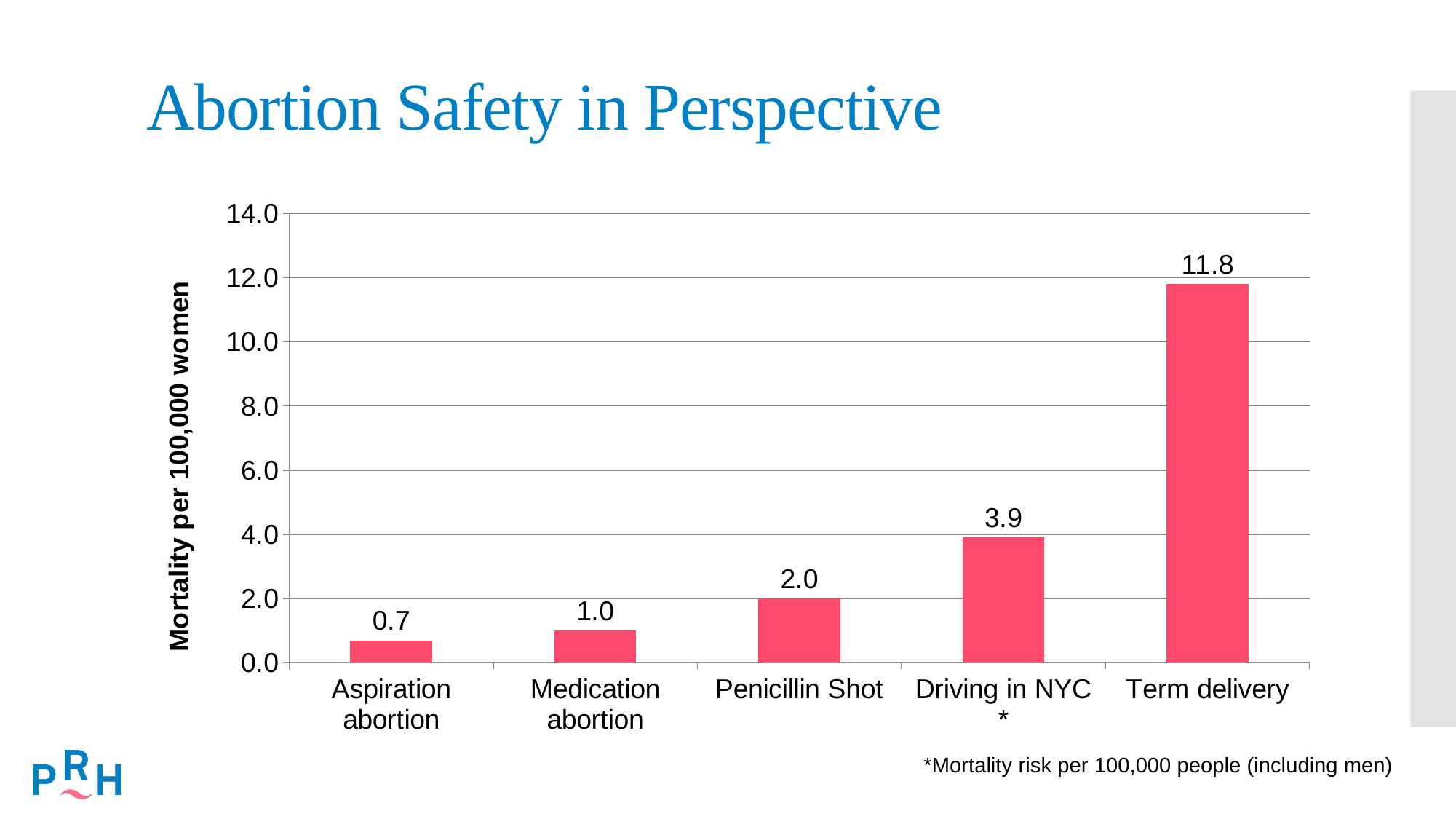
Which category has the lowest mortality per 100,000 women? Aspiration abortion What is the difference between the values for Medication abortion and Aspiration abortion? 0.3 How many categories are shown on the x axis? 5 What is the mortality value for Term delivery? 11.8 Which category has the highest mortality per 100,000 women? Term delivery What is the mortality value for Penicillin Shot? 2.0 What kind of chart is shown on the slide? Bar chart What is the label of the vertical axis? Mortality per 100,000 women What is the mortality value for Aspiration abortion? 0.7 Which is larger, the value for Penicillin Shot or the value for Medication abortion? Penicillin Shot What is the mortality value for Driving in NYC? 3.9 What is the difference between the values for Term delivery and Driving in NYC? 7.9